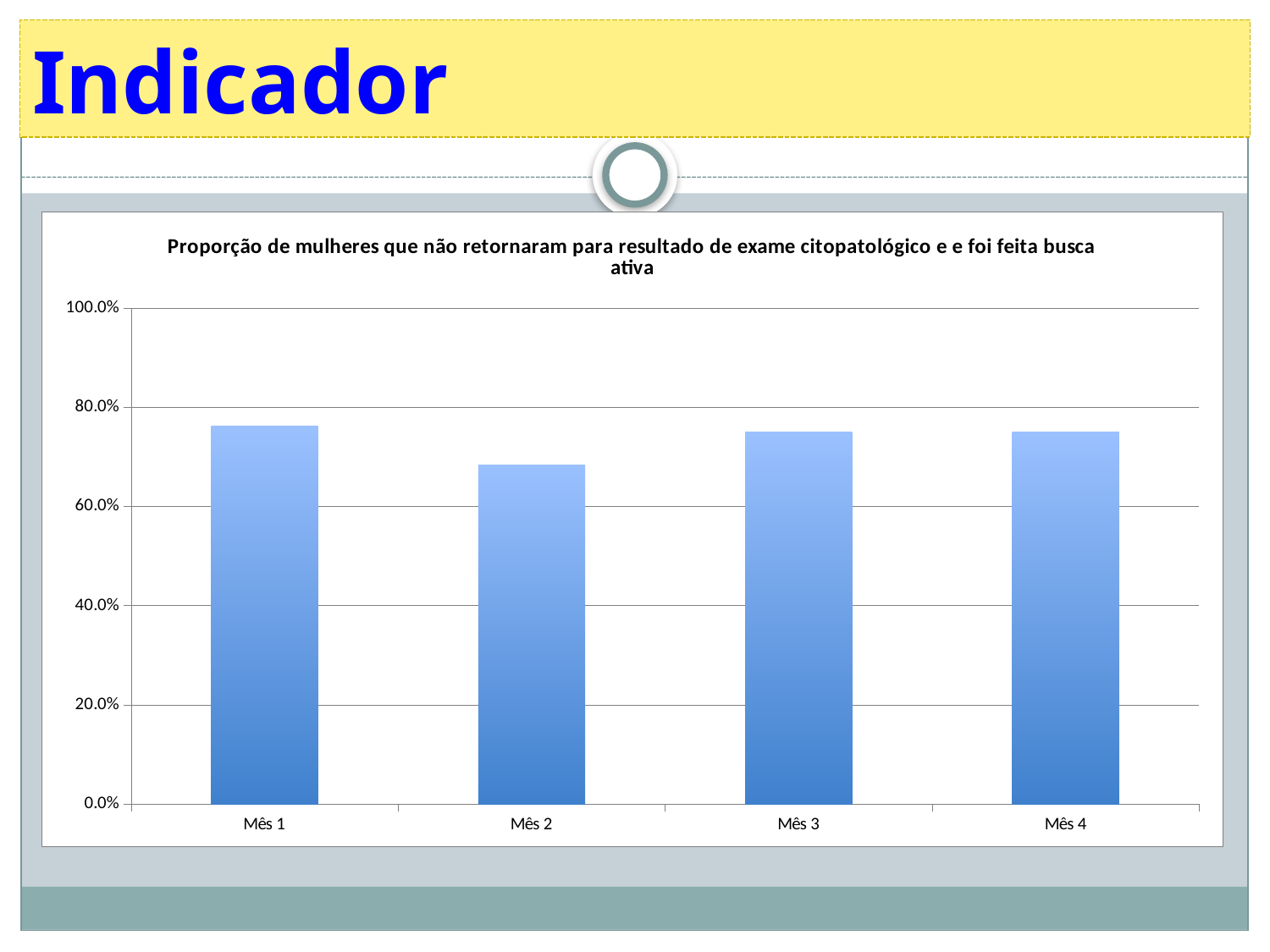
Is the value for Mês 4 greater or less than 60.0%? greater How many months (categories) are shown on the x axis of the chart? 4 Is the value for Mês 2 greater or less than 60.0%? greater Which month has the lowest value in the chart? Mês 2 What is the highest value shown on the chart's vertical axis? 100.0% What is the title of the chart? Proporção de mulheres que não retornaram para resultado de exame citopatológico e e foi feita busca ativa Which is larger, the value for Mês 2 or the value for Mês 3? Mês 3 Which is larger, the value for Mês 1 or the value for Mês 2? Mês 1 Is the value for Mês 1 greater or less than 60.0%? greater What kind of chart is shown on the slide? bar chart